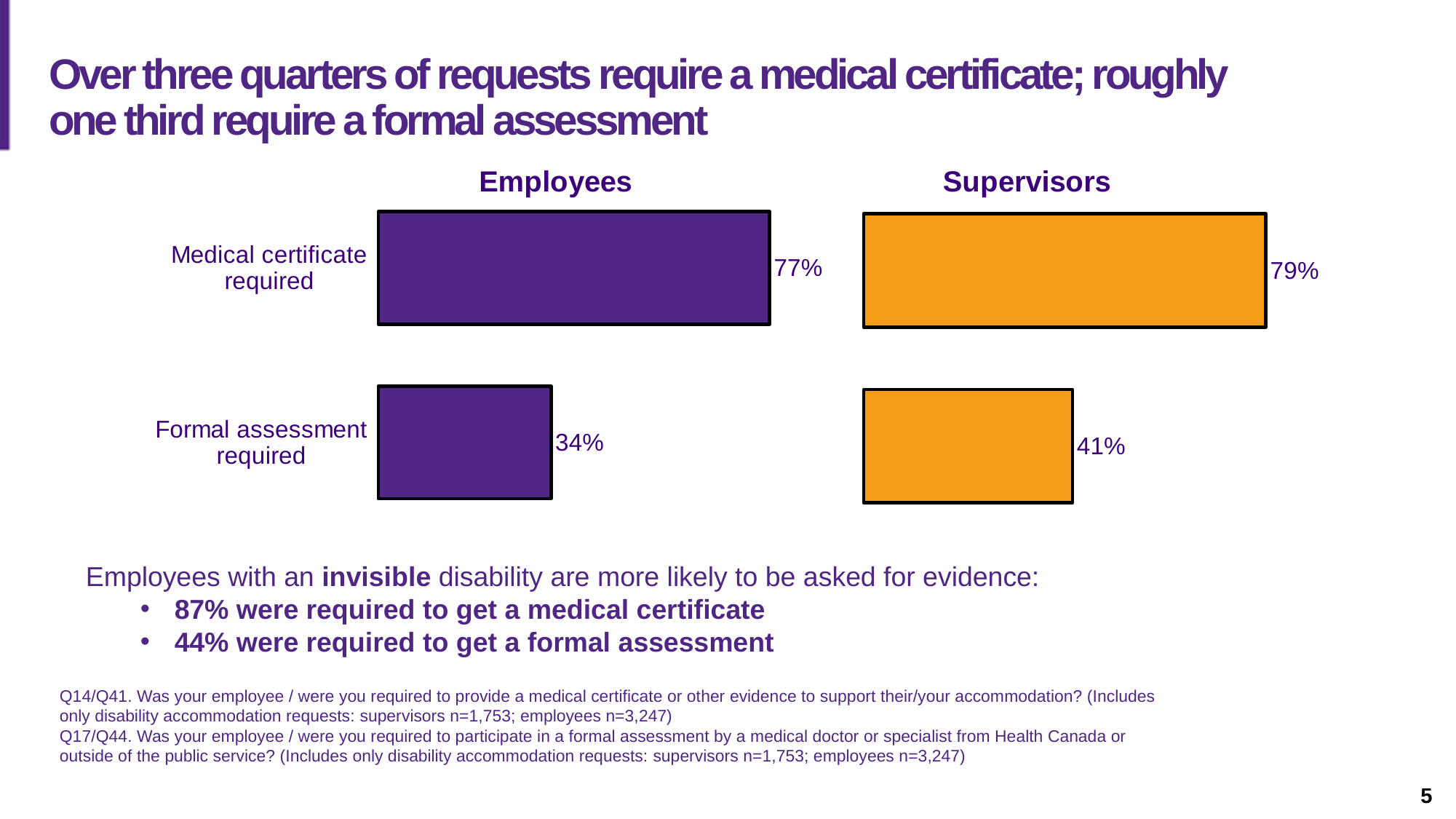
What type of chart is used for the Supervisors data? Bar chart In the Supervisors chart, what is the value for Medical certificate required? 79% In the Supervisors chart, which category has the lowest value? Formal assessment required What is the difference between the Supervisors and Employees values for Formal assessment required? 7 percentage points In the Employees chart, which category has the highest value? Medical certificate required What colour are the bars in the Supervisors chart? Orange How many categories are shown in the Employees chart? 2 In the Employees chart, what percentage of requests required a medical certificate? 77% For Medical certificate required, which is larger: the Employees value or the Supervisors value? Supervisors In the Employees chart, what is the value for Formal assessment required? 34% In the Supervisors chart, what percentage of requests required a formal assessment? 41% In the Employees chart, what is the difference between Medical certificate required and Formal assessment required? 43 percentage points